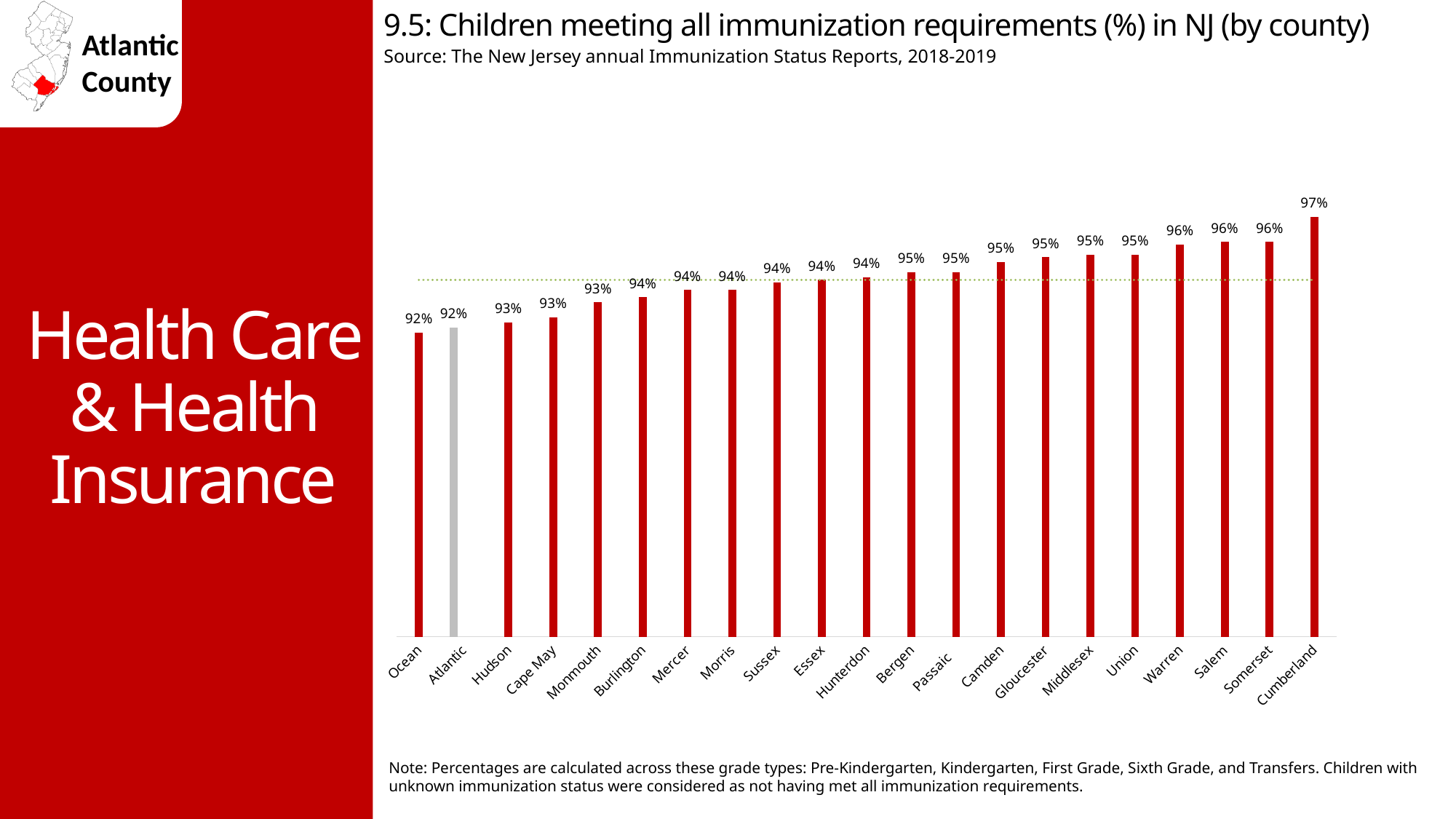
What kind of chart is used on this slide? Bar chart What is the value for Middlesex County? 95% Which county has a higher value, Salem or Hudson? Salem Which county has the highest percentage of children meeting all immunization requirements? Cumberland What percentage is shown for Hunterdon County? 94% What is the source cited for the chart data? The New Jersey annual Immunization Status Reports, 2018-2019 Do the values rise or fall moving from left to right along the x axis? Rise What is the value shown for Atlantic County? 92% What is the difference in percentage points between Cumberland and Ocean counties? 5 percentage points Which county's bar is coloured grey instead of red? Atlantic What percentage of children in Cumberland County meet all immunization requirements? 97% How many counties are shown on the chart? 21